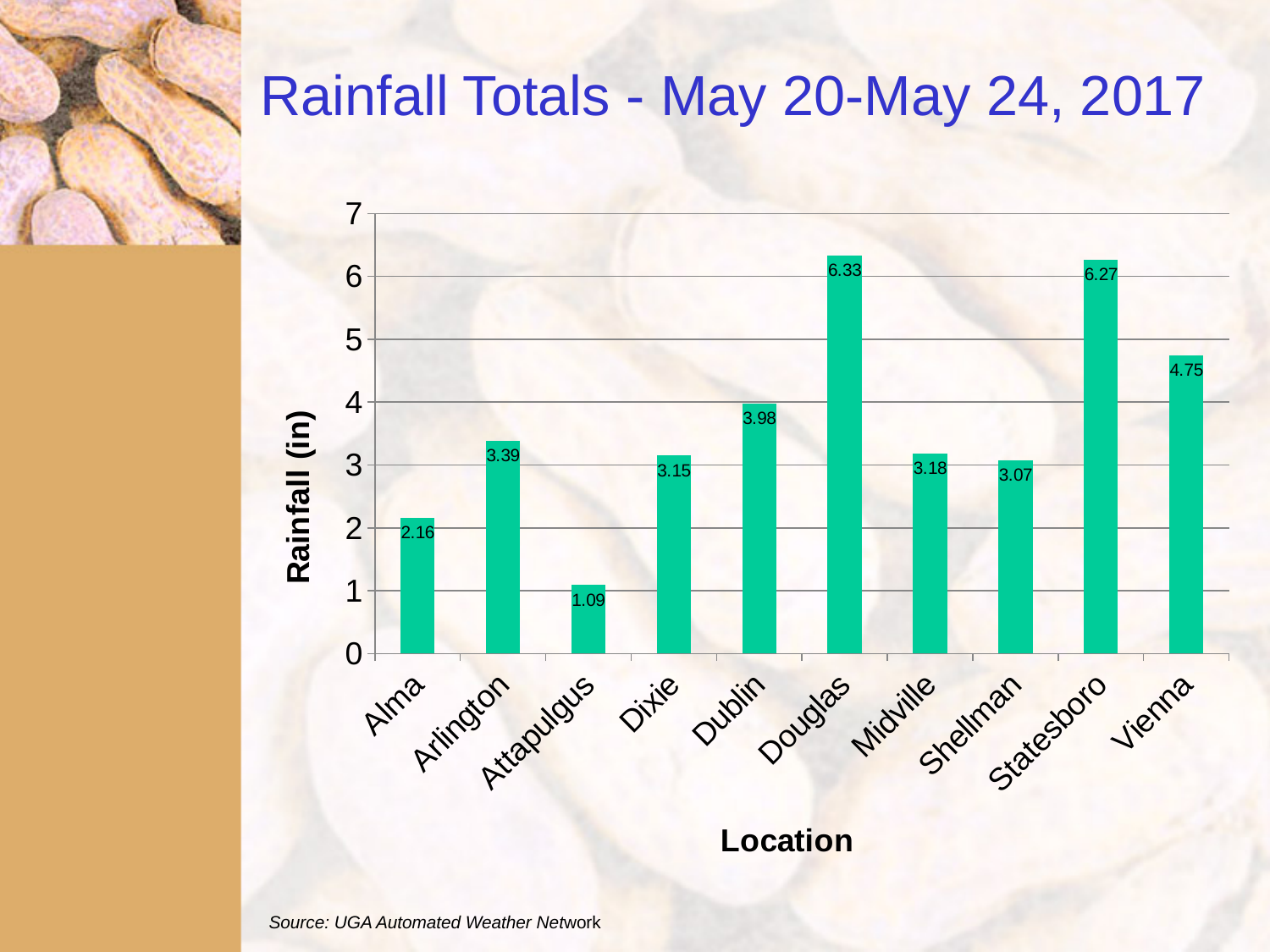
What is the label of the y axis? Rainfall (in) Which location has the lowest rainfall total? Attapulgus Which location had more rainfall, Dublin or Arlington? Dublin Which location has the highest rainfall total? Douglas What is the rainfall total for Douglas? 6.33 What is the title of the chart? Rainfall Totals - May 20-May 24, 2017 How many locations are shown in the chart? 10 What is the rainfall total for Vienna? 4.75 Is the value for Midville greater or less than 3? greater What is the difference in rainfall between Statesboro and Alma? 4.11 What type of chart is shown on the slide? bar chart What is the rainfall total for Attapulgus? 1.09